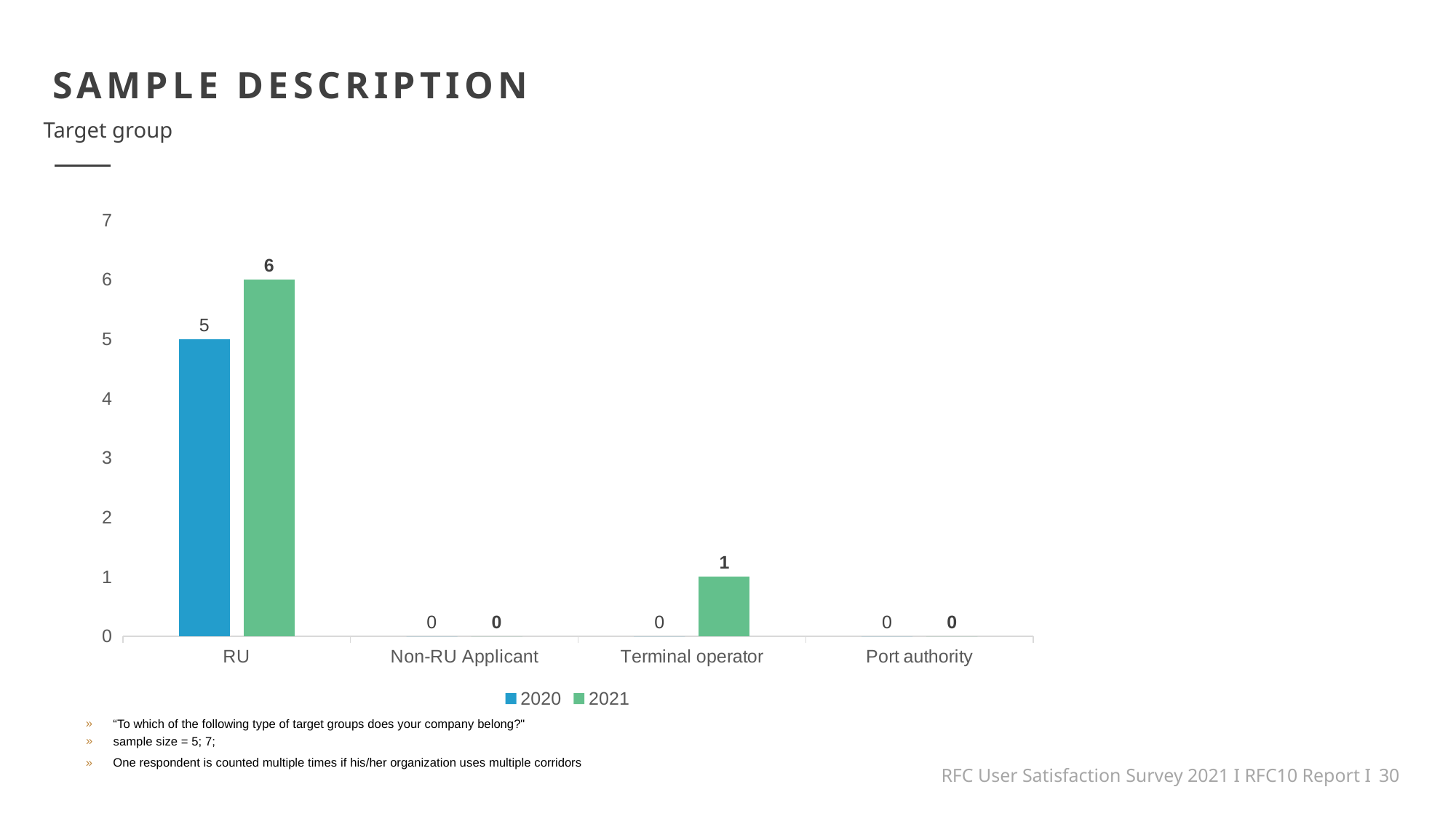
What is the value for RU in the 2021 series? 6 What is the difference between the 2021 and 2020 values for RU? 1 How many categories are shown on the x axis? 4 What is the value for Terminal operator in the 2021 series? 1 Which is larger for RU: the 2020 value or the 2021 value? 2021 How many series does the legend list? 2 Is the 2021 value for RU greater or less than 4? greater What are the two series listed in the legend? 2020 and 2021 What kind of chart is shown on the slide? bar chart What is the value for Non-RU Applicant in the 2020 series? 0 Which category has the highest value in the 2021 series? RU What is the value for RU in the 2020 series? 5